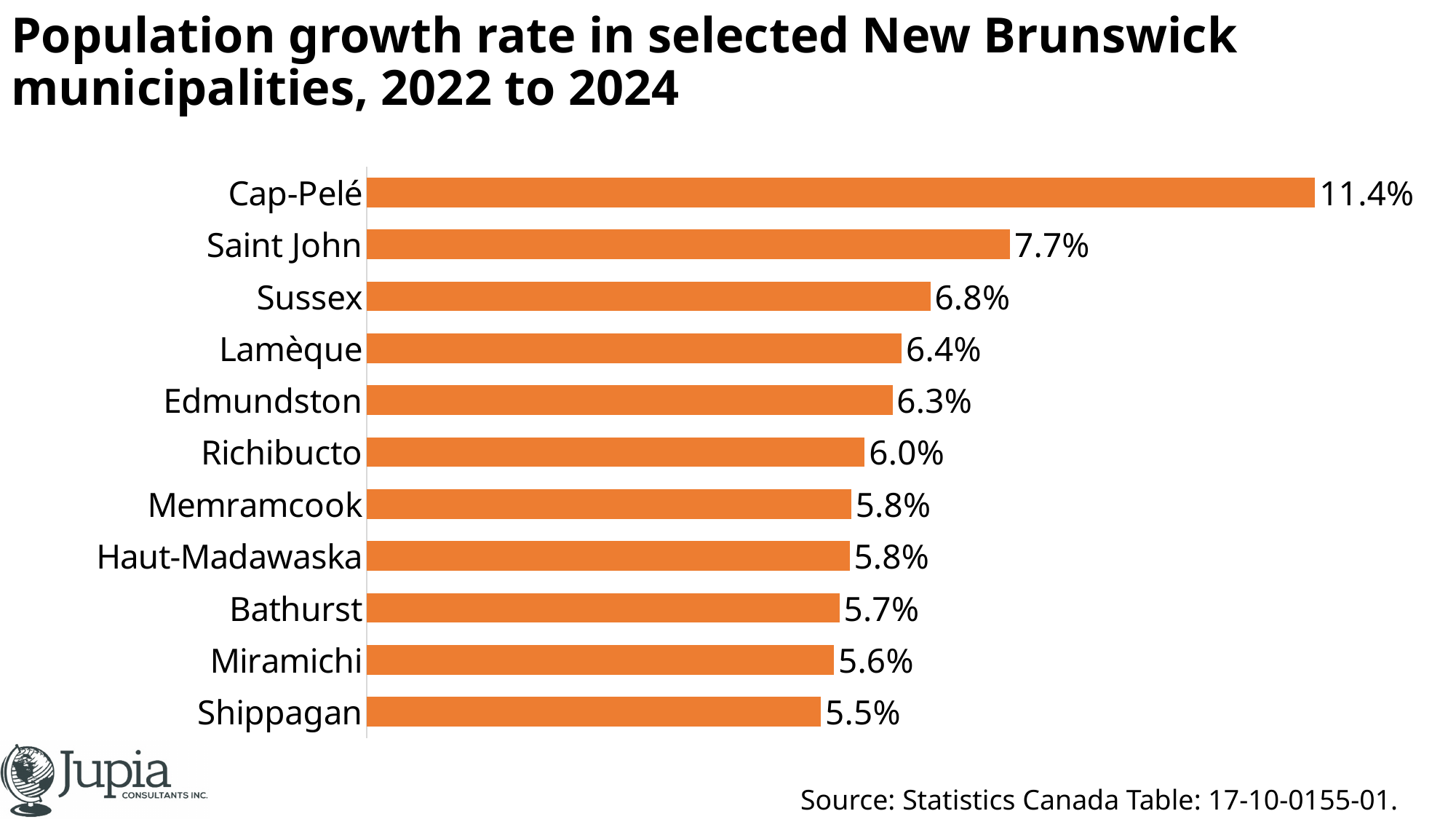
What is the population growth rate for Miramichi? 5.6% Which municipality has the highest population growth rate? Cap-Pelé What is the population growth rate for Saint John? 7.7% Which has a higher population growth rate, Lamèque or Richibucto? Lamèque What is the population growth rate for Edmundston? 6.3% What is the difference between the growth rates of Sussex and Shippagan? 1.3% Which municipality has the lowest population growth rate? Shippagan What is the difference between the growth rates of Cap-Pelé and Saint John? 3.7% What kind of chart is shown on the slide? Bar chart What is the source cited for the chart data? Statistics Canada Table: 17-10-0155-01 How many municipalities are shown in the chart? 11 What is the population growth rate for Cap-Pelé? 11.4%